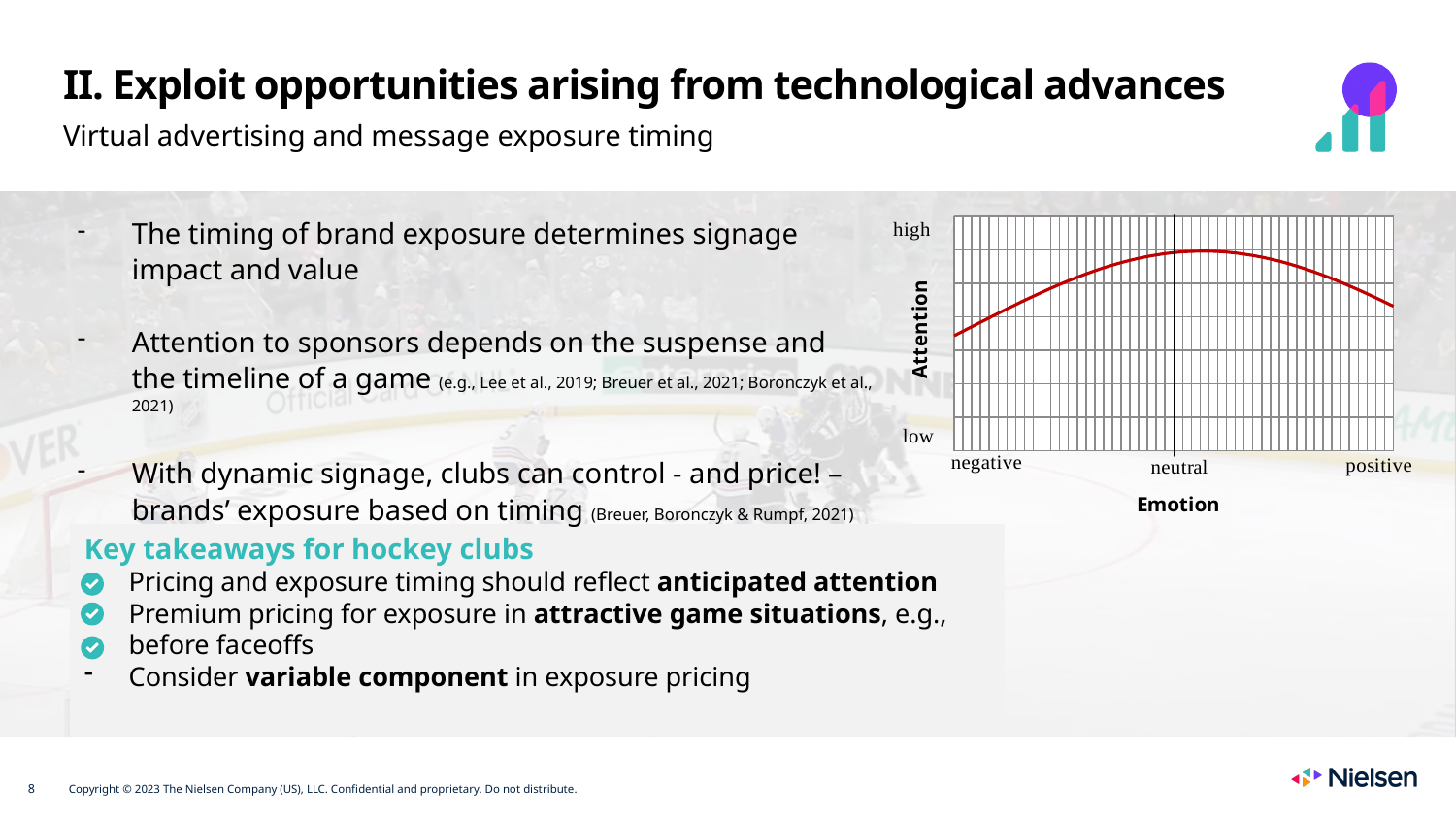
Is attention higher at the negative end or the positive end of the emotion axis? positive What kind of chart is shown on the slide? line chart What is the label of the y axis of the chart? Attention How many emotion categories are labelled along the x axis of the chart? 3 What are the two labels shown at the ends of the Attention axis? low and high At which labelled emotion is attention highest in the chart? neutral At which labelled emotion is attention lowest in the chart? negative Does attention rise or fall as emotion moves from negative to neutral? rise Is attention at neutral emotion higher or lower than at negative emotion? higher Does attention rise or fall as emotion moves from neutral to positive? fall How many lines are plotted in the chart? 1 What is the label of the x axis of the chart? Emotion